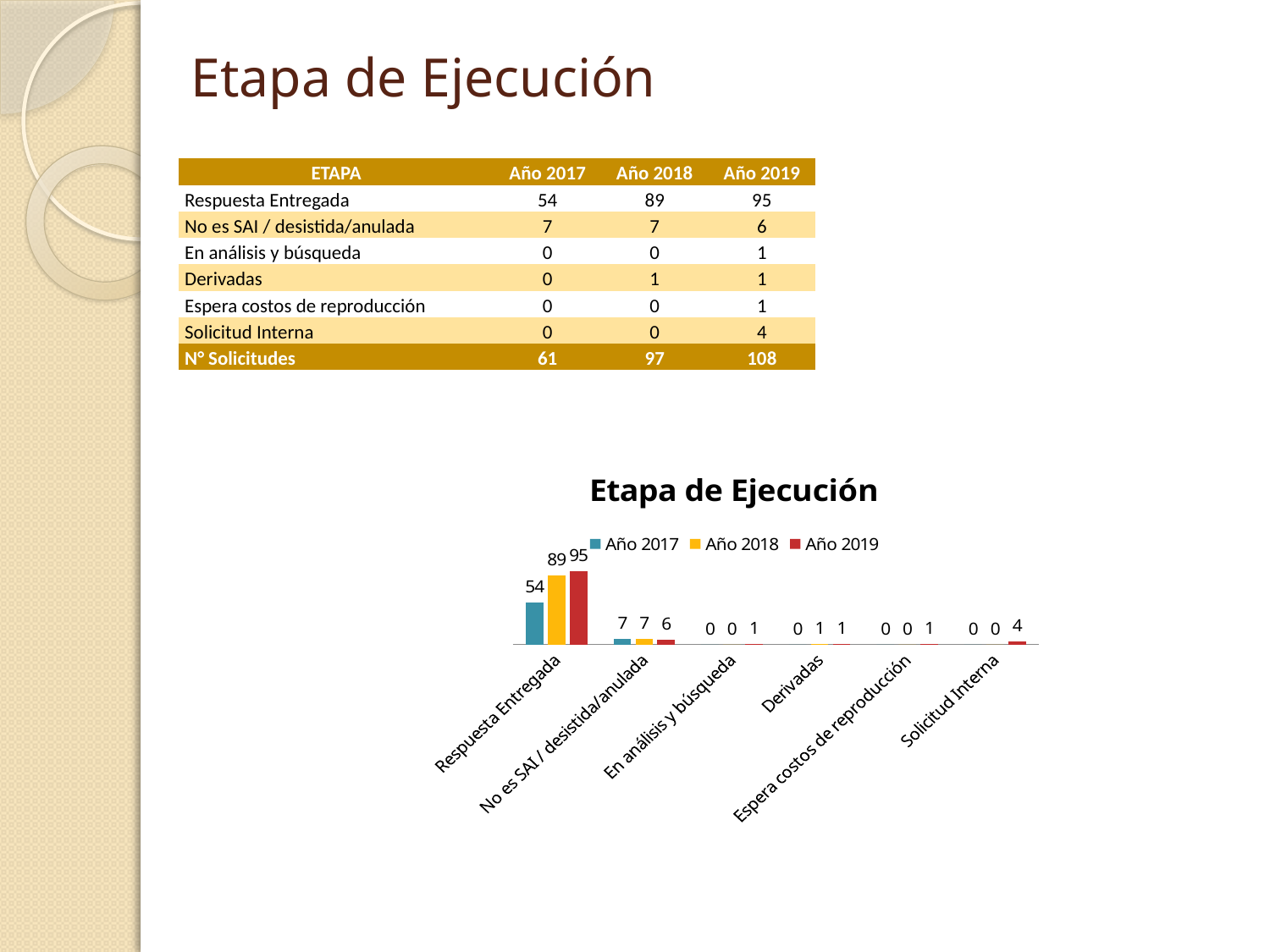
Which category has the highest value in the Año 2018 series? Respuesta Entregada How many series does the legend list? 3 How many categories are shown on the x axis of the chart? 6 What kind of chart is shown on the slide? bar chart What is the value for Respuesta Entregada in the Año 2019 series? 95 What is the value for No es SAI / desistida/anulada in the Año 2017 series? 7 Which is larger for Respuesta Entregada: the Año 2018 value or the Año 2017 value? Año 2018 What is the difference between the Año 2019 and Año 2017 values for Respuesta Entregada? 41 What is the title of the chart? Etapa de Ejecución What is the value for Solicitud Interna in the Año 2019 series? 4 What is the value for Derivadas in the Año 2018 series? 1 Which colour represents the Año 2019 series in the chart? red